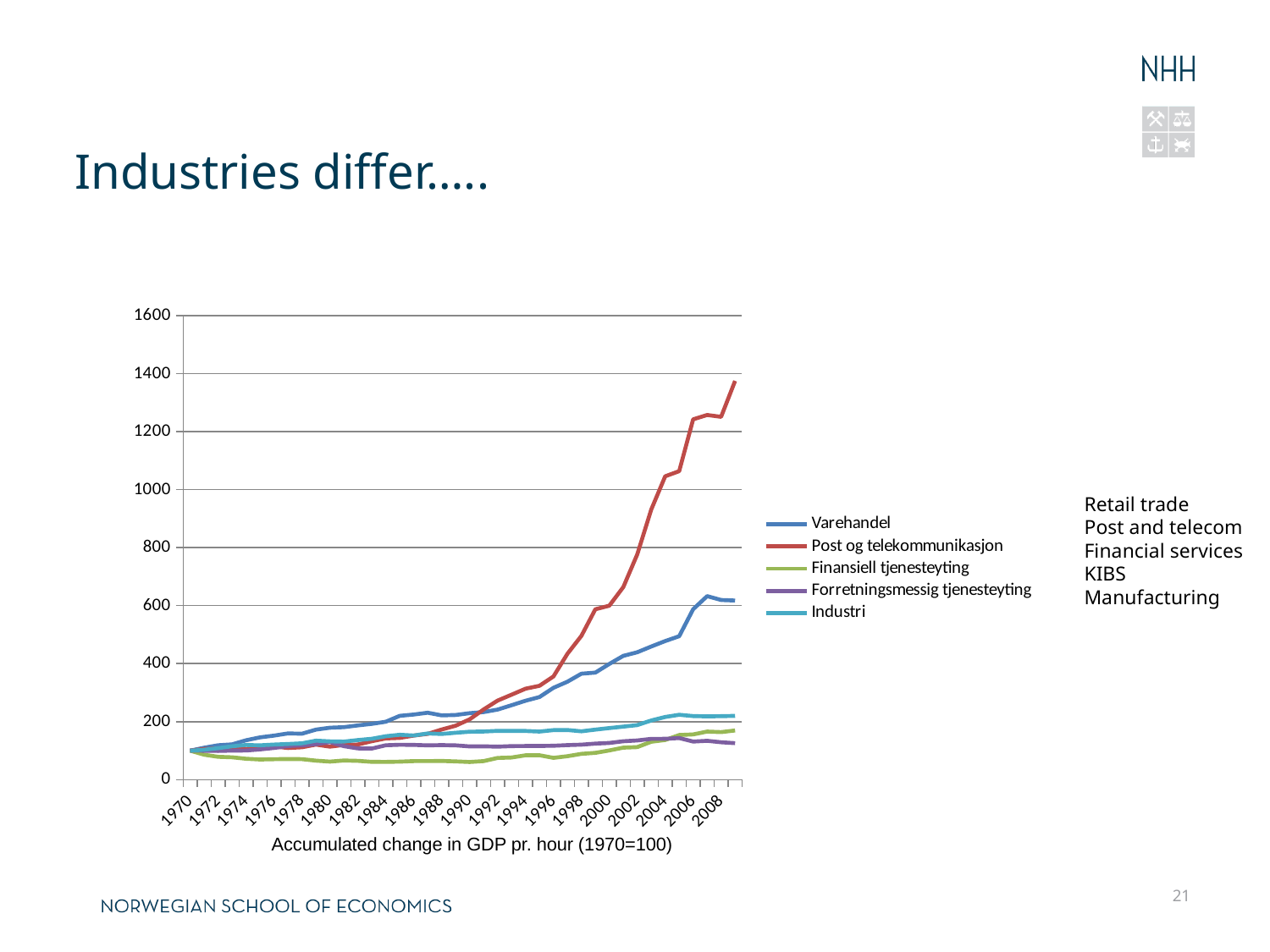
What kind of chart is shown on the slide? line chart Is the value for Forretningsmessig tjenesteyting in 2008 greater or less than 200? less Which series has the highest value in 2008? Post og telekommunikasjon What is the caption printed below the x axis of the chart? Accumulated change in GDP pr. hour (1970=100) How many series does the chart's legend list? 5 Is the value for Industri in 2008 greater or less than 400? less Is the value for Post og telekommunikasjon in 2008 greater or less than 1200? greater In 2008, which is larger: the value for Varehandel or the value for Industri? Varehandel Does the Post og telekommunikasjon series rise or fall from 1970 to 2008? rise Which series has the lowest value in 2008? Forretningsmessig tjenesteyting What colour is the Post og telekommunikasjon line in the chart? red